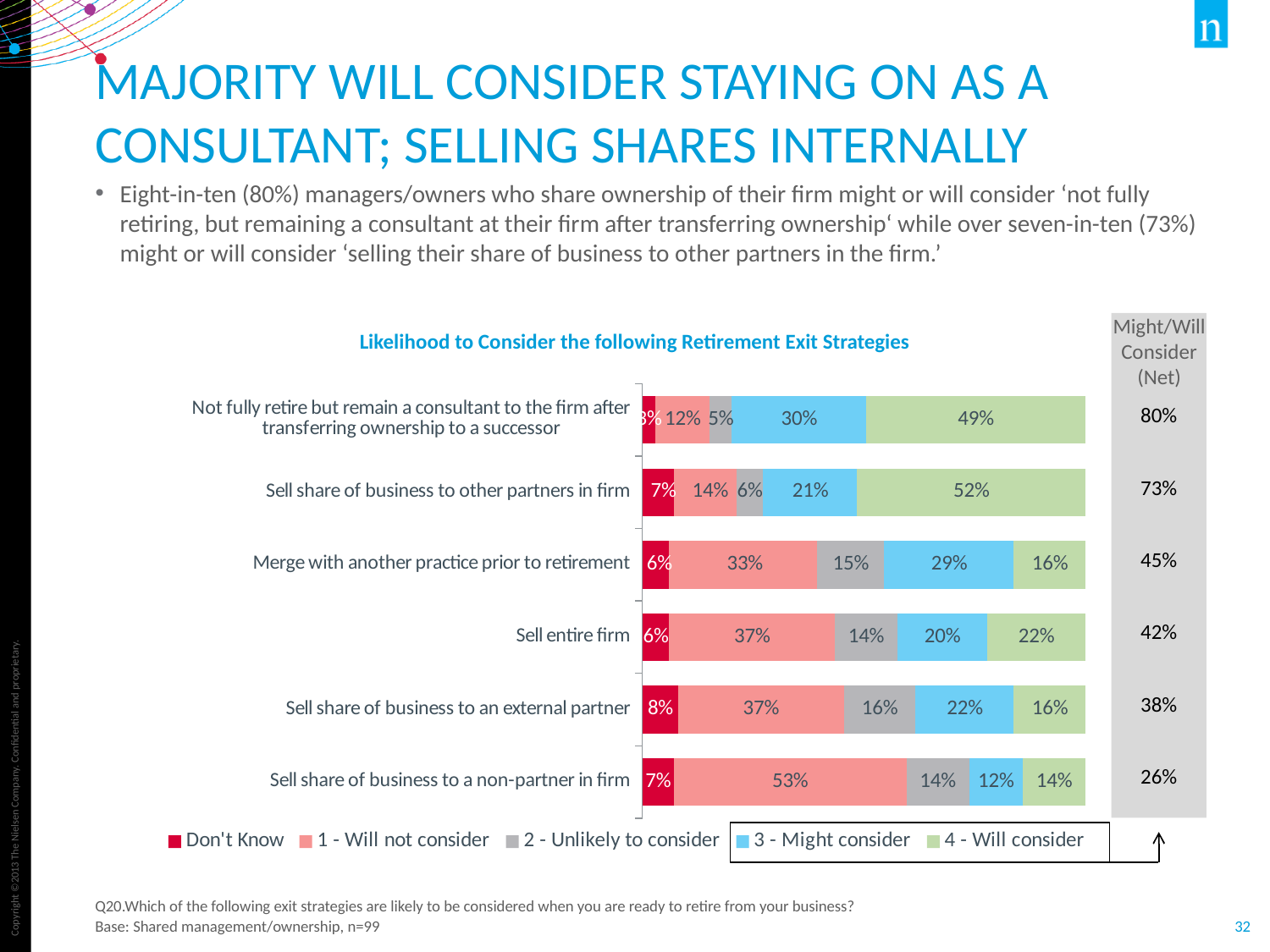
What kind of chart is shown on the slide? Stacked bar chart Which exit strategy has the lowest Might/Will Consider (Net) value? Sell share of business to a non-partner in firm What percentage of respondents said they 'Will consider' selling their share of business to other partners in the firm? 52% Which has a larger 'Will not consider' share: 'Merge with another practice prior to retirement' or 'Sell entire firm'? Sell entire firm What is the difference between the 'Will consider' values for 'Sell entire firm' and 'Sell share of business to an external partner'? 6% What is the Might/Will Consider (Net) value for 'Sell entire firm'? 42% What percentage said they 'Will not consider' selling their share of business to a non-partner in the firm? 53% What is the 'Might consider' value for 'Merge with another practice prior to retirement'? 29% How many series does the chart legend list? 5 How many exit strategies (categories) are plotted in the chart? 6 Which exit strategy has the highest Might/Will Consider (Net) value? Not fully retire but remain a consultant to the firm after transferring ownership to a successor What colour represents the '4 - Will consider' series in the chart? Green